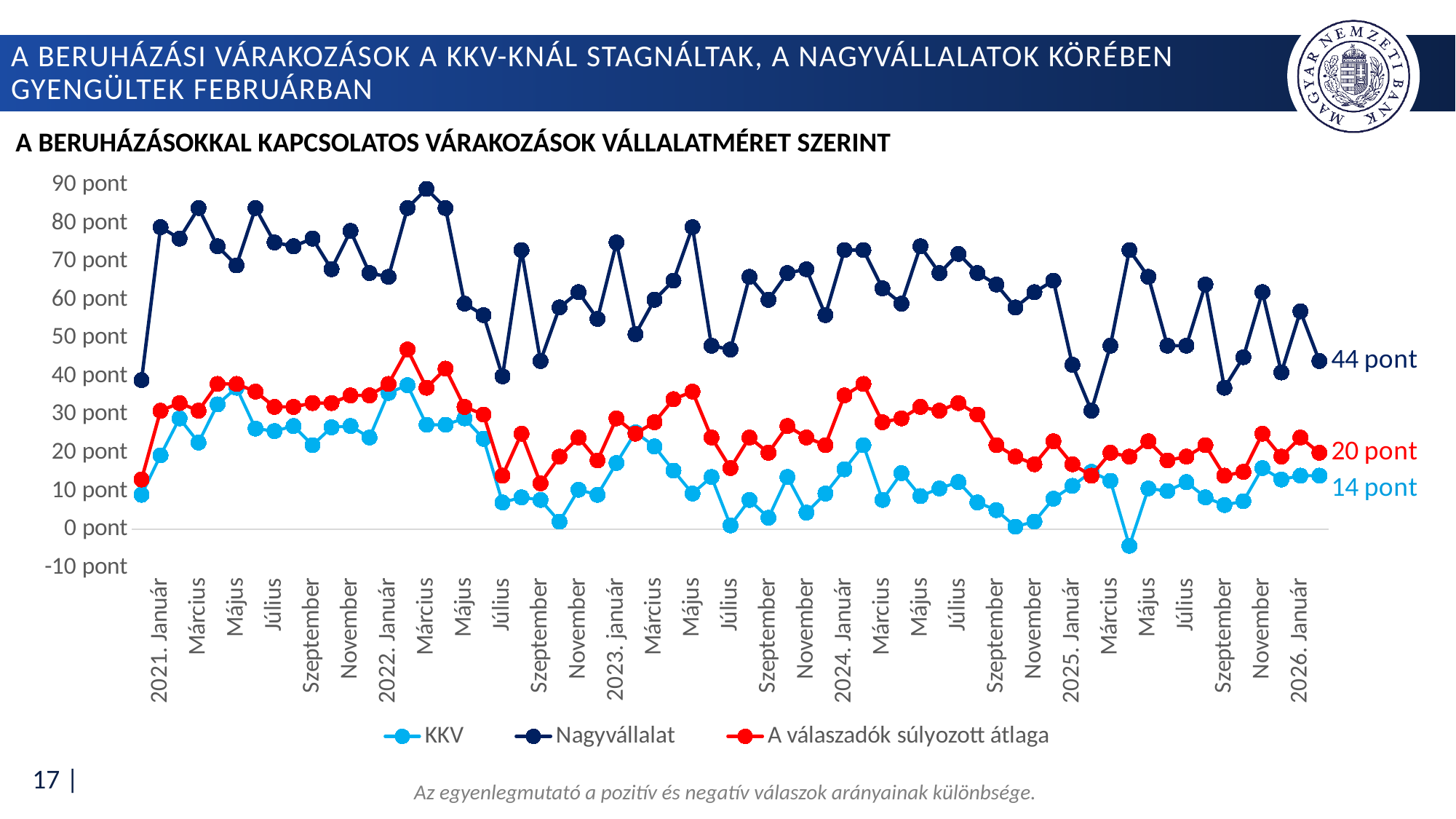
Is the KKV value for 2025 May greater or less than 0 pont? greater Is the Nagyvállalat value for 2022 March greater or less than 80 pont? greater What type of chart is shown on the slide? line chart Which series has the highest value at the end of the chart (2026)? Nagyvállalat What is the latest value shown for the Nagyvállalat series? 44 pont What is the difference between the latest Nagyvállalat value and the latest KKV value? 30 pont How many series does the legend list? 3 What is the latest value shown for the KKV series? 14 pont What is the latest value shown for the 'A válaszadók súlyozott átlaga' series? 20 pont What is the title of the chart? A BERUHÁZÁSOKKAL KAPCSOLATOS VÁRAKOZÁSOK VÁLLALATMÉRET SZERINT What is the difference between the latest 'A válaszadók súlyozott átlaga' value and the latest KKV value? 6 pont Which series has the lowest value at the end of the chart (2026)? KKV